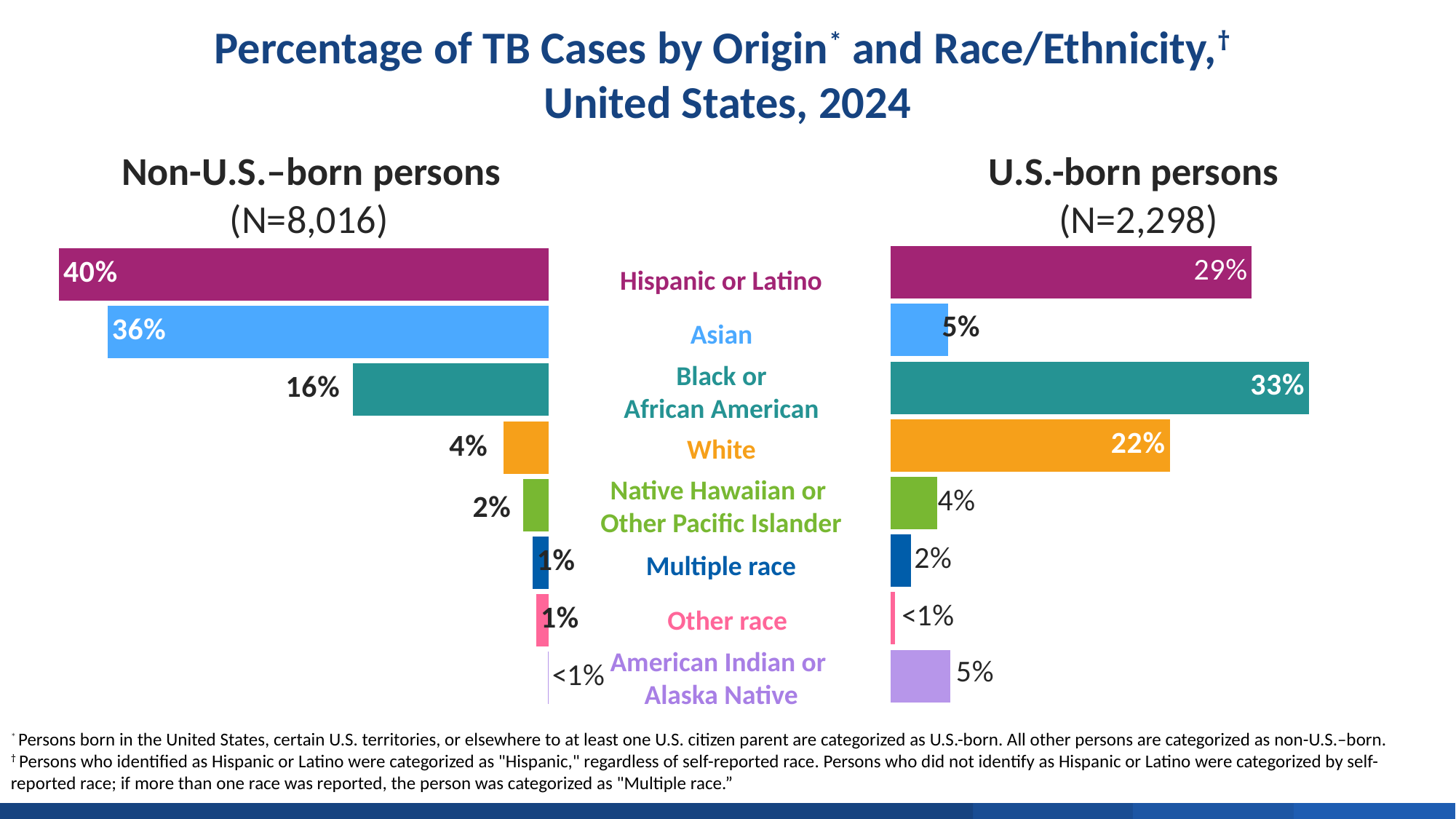
What is the total number of cases (N) shown for U.S.-born persons? 2,298 In the Non-U.S.-born persons chart, which race/ethnicity category has the highest percentage? Hispanic or Latino What type of chart is used on this slide? Bar chart In the Non-U.S.-born persons chart, what percentage of TB cases were among Hispanic or Latino persons? 40% In the U.S.-born persons chart, which race/ethnicity category has the highest percentage? Black or African American In the U.S.-born persons chart, what percentage of TB cases were among White persons? 22% In the U.S.-born persons chart, what percentage of TB cases were among Black or African American persons? 33% In the Non-U.S.-born persons chart, what is the difference between the Hispanic or Latino and Black or African American percentages? 24% In the U.S.-born persons chart, what is the difference between the Black or African American and White percentages? 11% How many race/ethnicity categories are shown in each chart? 8 In the Non-U.S.-born persons chart, what percentage of TB cases were among Asian persons? 36% Is the percentage for Asian persons larger in the Non-U.S.-born persons chart or the U.S.-born persons chart? Non-U.S.-born persons